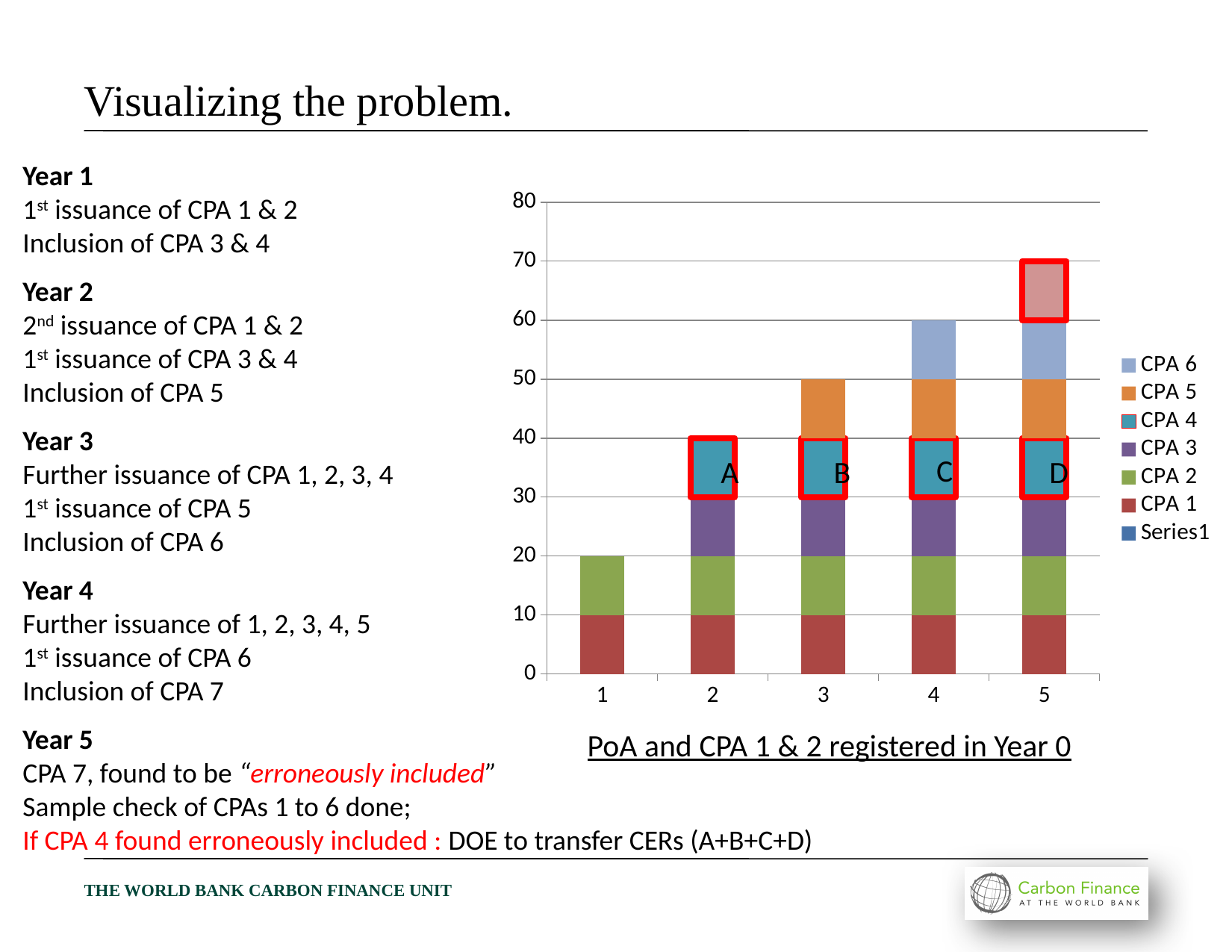
What is the total height of the stacked bar for category 4? 60 Which legend series do the red-outlined segments labelled A, B, C and D belong to? CPA 4 Which category has the shortest stacked bar? 1 What kind of chart is shown on the slide? stacked bar chart Is the total for category 2 greater or less than 50? less What is the total height of the stacked bar for category 1? 20 How many series does the chart's legend list? 7 Is the total for category 3 greater or less than 40? greater Which category has the tallest stacked bar? 5 Do the stacked bar totals rise or fall from category 1 to category 5? rise Which stacked bar is taller, category 2 or category 4? category 4 How many categories are shown on the x axis of the chart? 5